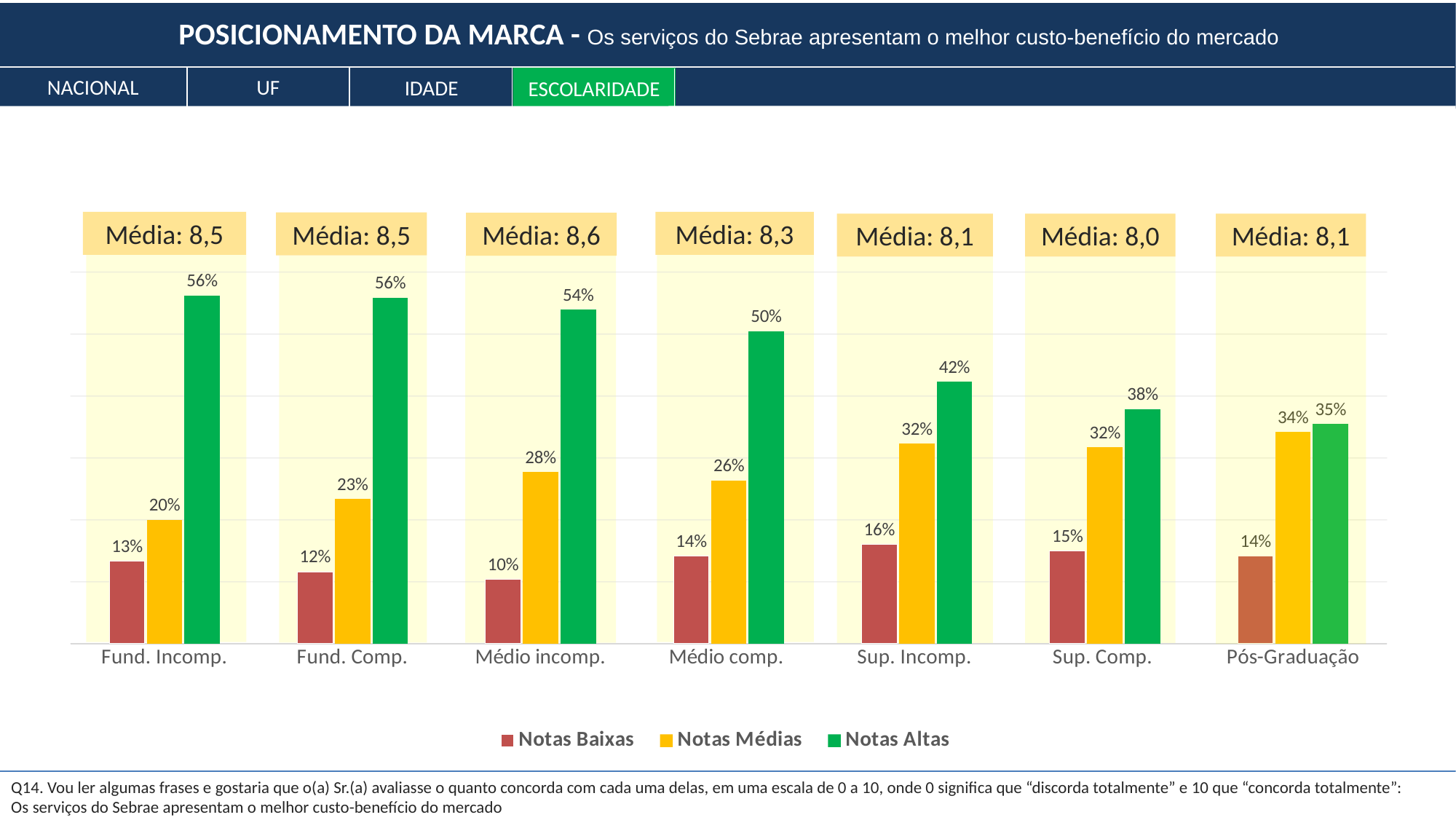
Which is larger for Sup. Comp.: Notas Médias or Notas Altas? Notas Altas What kind of chart is shown on the slide? Bar chart Do the Notas Altas values rise or fall from Médio incomp. to Pós-Graduação? Fall What is the value of Notas Médias for Pós-Graduação? 34% What is the value of Notas Baixas for Sup. Incomp.? 16% Which category has the lowest Notas Baixas value? Médio incomp. How many series does the legend list? 3 What is the value of Notas Altas for Médio incomp.? 54% What is the difference between Notas Altas and Notas Baixas for Fund. Comp.? 44% Which category has the highest Notas Médias value? Pós-Graduação How many education categories are shown on the x axis? 7 What is the Média shown above the Sup. Comp. category? 8,0